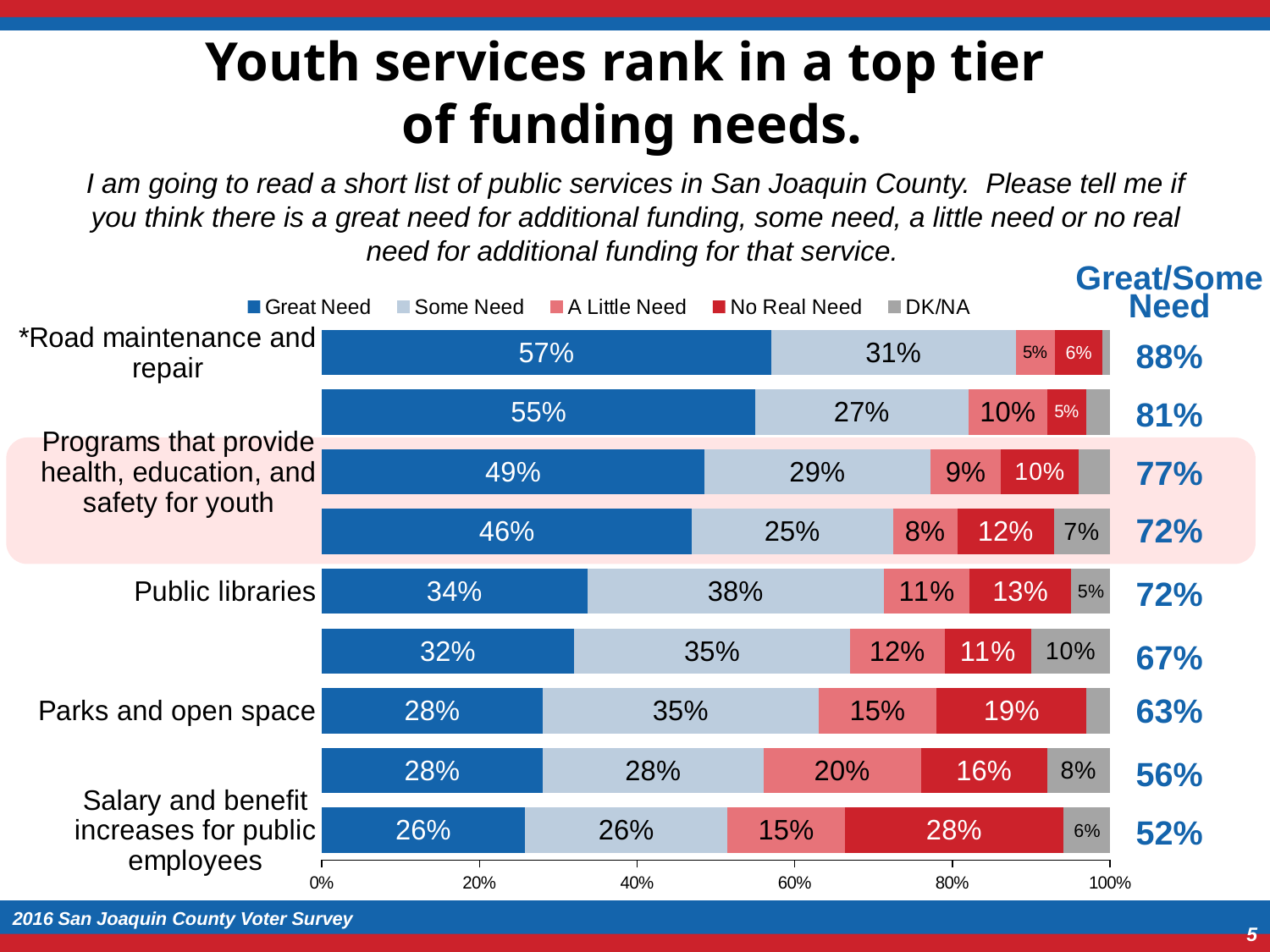
Which service has the highest Great Need percentage? Road maintenance and repair What is the Great/Some Need total for salary and benefit increases for public employees? 52% Which service has the lowest Great/Some Need total? Salary and benefit increases for public employees What is the Great/Some Need total shown for road maintenance and repair? 88% What percentage said No Real Need for parks and open space? 19% How many series does the legend list? 5 How many bars are plotted in the chart? 9 What percentage of respondents said there is a Great Need for additional funding for road maintenance and repair? 57% How many percentage points higher is the Great Need share for road maintenance and repair than for public libraries? 23 percentage points What type of chart is shown on the slide? Stacked bar chart Which has a larger Some Need share: public libraries or parks and open space? Public libraries What percentage said Some Need for public libraries? 38%